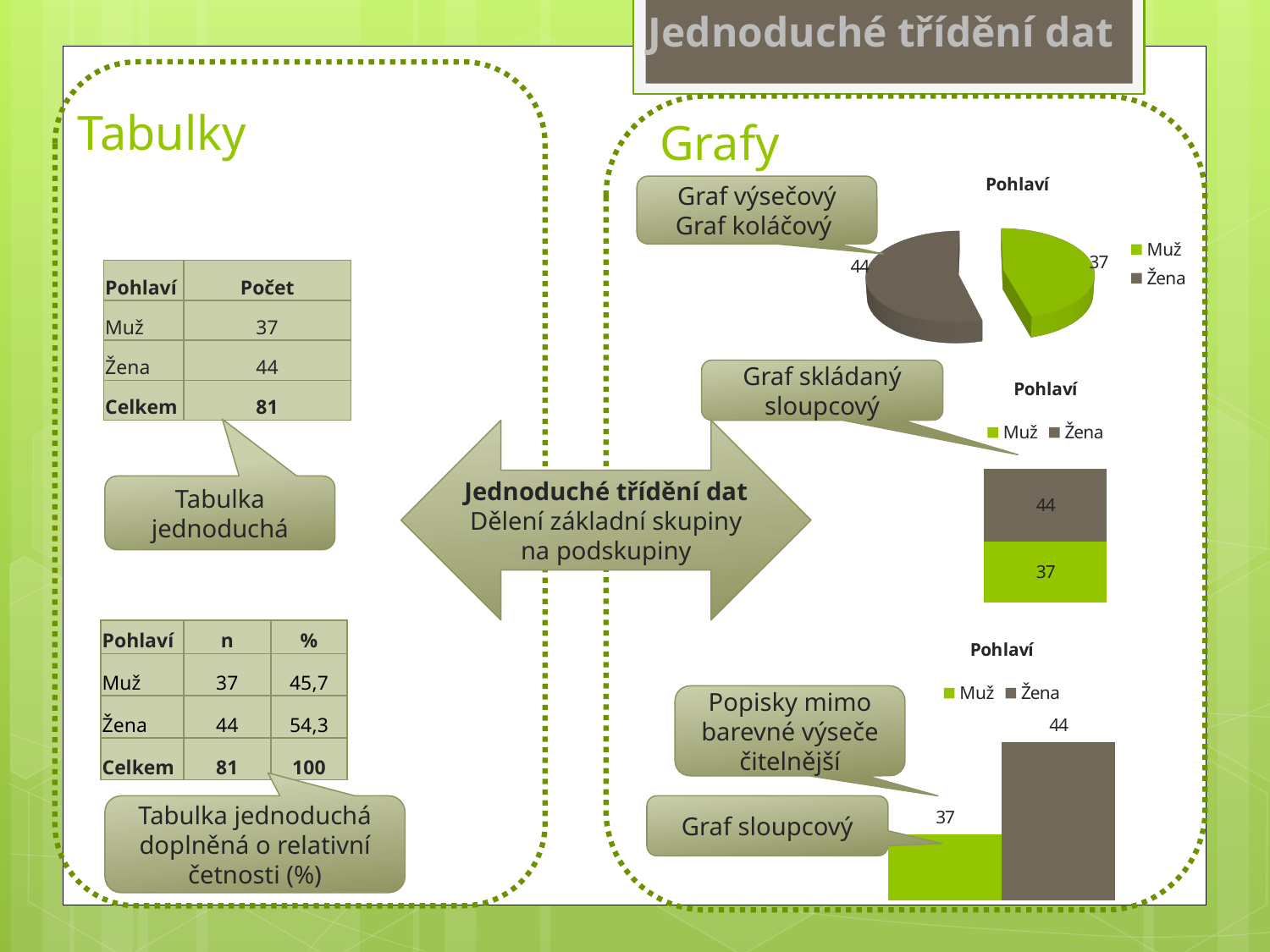
In the bar chart at the bottom right, what is the value for Muž? 37 In the stacked bar chart in the middle right, what is the total of the stacked bar? 81 In the stacked bar chart in the middle right, how many series does the legend list? 2 In the pie chart at the top right, what is the value for Muž? 37 In the stacked bar chart in the middle right, what is the value of the Žena segment? 44 In the pie chart at the top right, which category has the larger slice? Žena What type of chart is shown at the bottom right of the slide? Bar chart In the pie chart at the top right, what is the value for Žena? 44 In the bar chart at the bottom right, which is larger, Muž or Žena? Žena In the bar chart at the bottom right, what is the difference between the Žena and Muž values? 7 In the pie chart at the top right, how many slices are there? 2 What is the title of the pie chart at the top right? Pohlaví